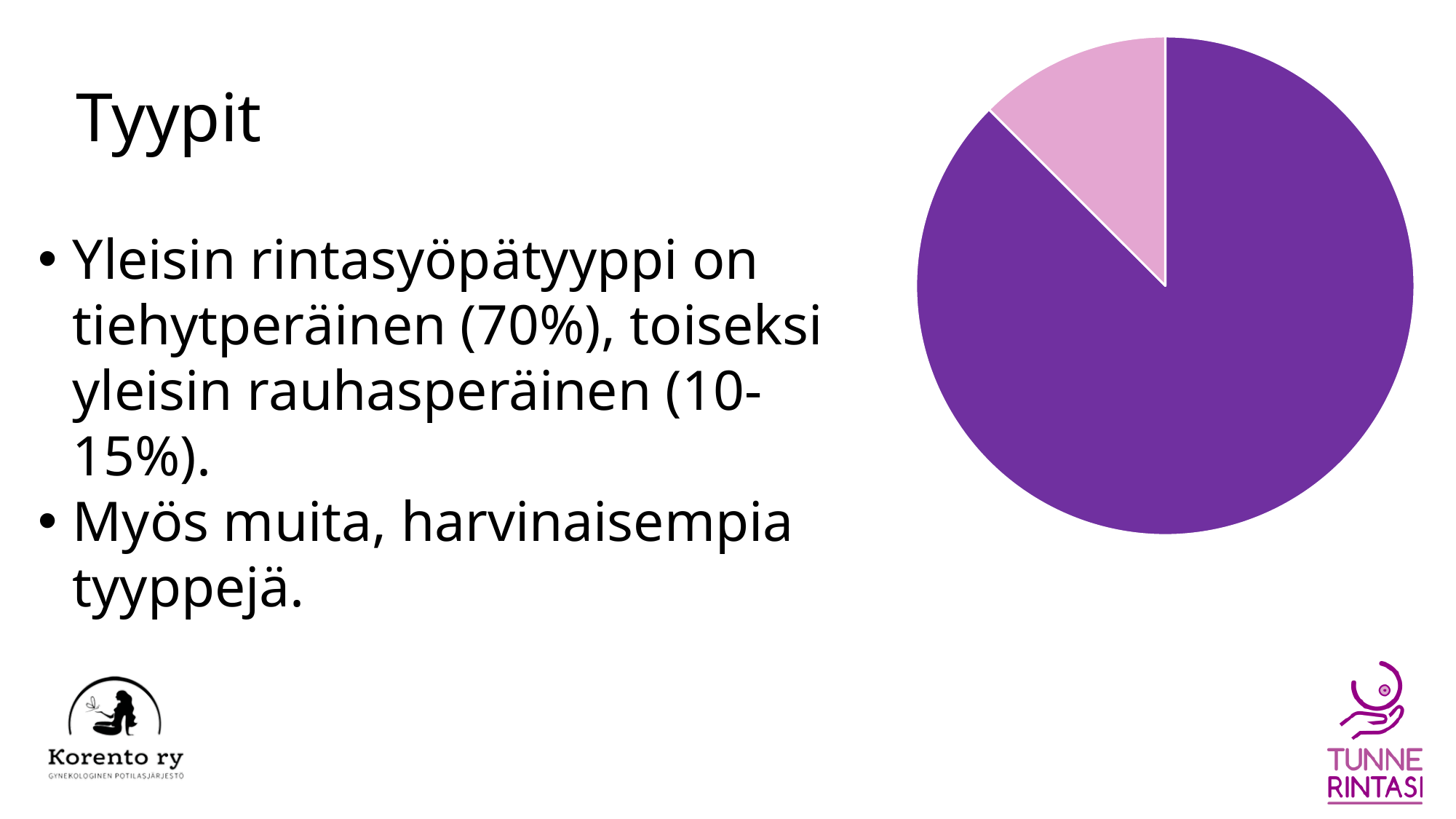
How many slices does the pie chart have? 2 Which slice of the pie chart is larger, the dark purple one or the light pink one? the dark purple one Does the pie chart show data labels on its slices? No Which colour is used for the largest slice of the pie chart? dark purple Which colour is used for the smallest slice of the pie chart? light pink Does the pie chart display a legend? No What kind of chart is shown on the right side of the slide? pie chart